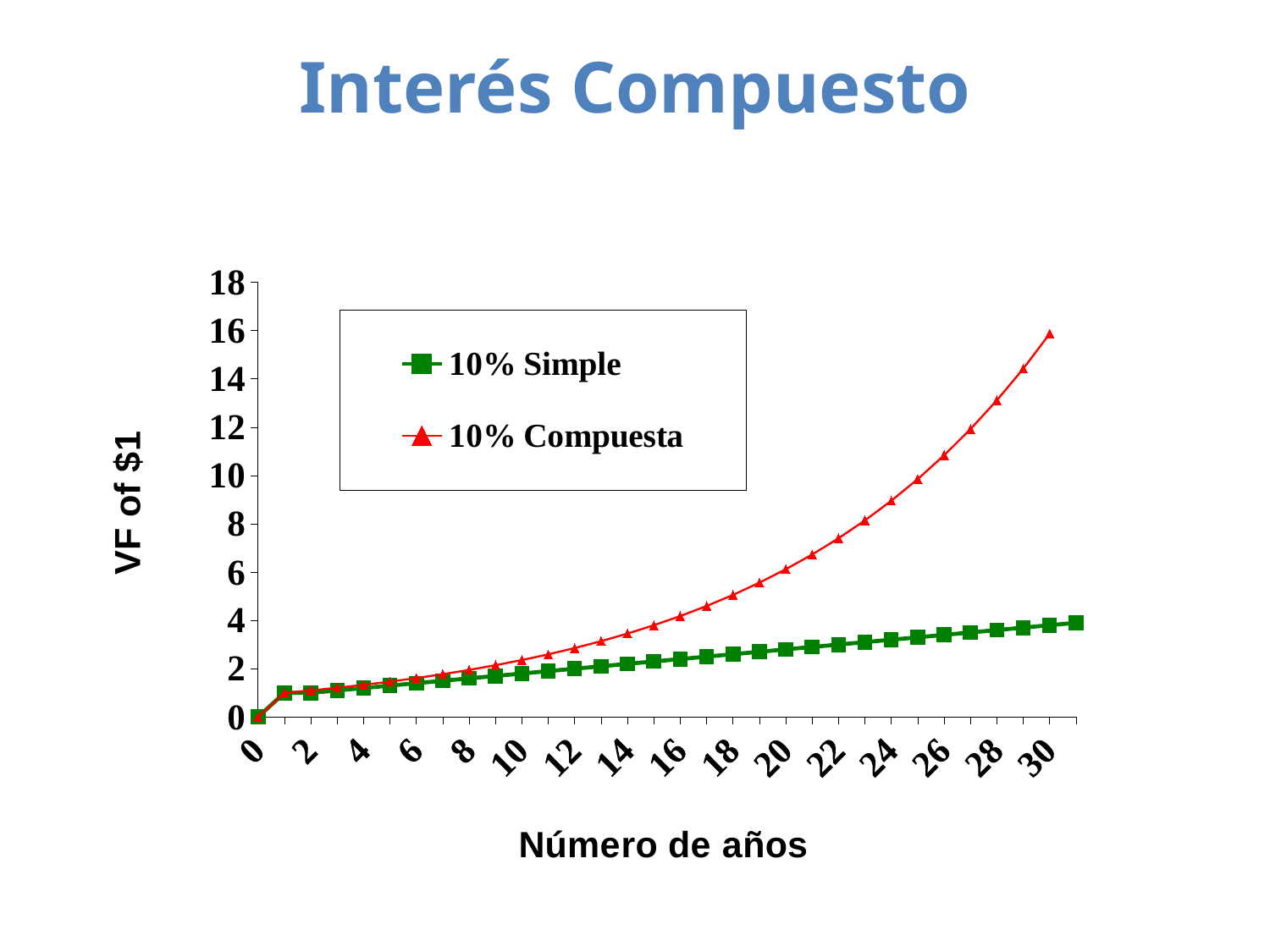
Is the value for 10% Compuesta at year 30 greater or less than 14? greater Do the values for 10% Compuesta rise or fall as the number of years increases? rise At year 30, which series has the higher value, 10% Simple or 10% Compuesta? 10% Compuesta Is the value for 10% Compuesta at year 26 greater or less than 8? greater What is the label of the y axis? VF of $1 How many series does the legend list? 2 Is the value for 10% Compuesta at year 20 greater or less than 4? greater What kind of chart is shown on the slide? line chart Do the values for 10% Simple rise or fall as the number of years increases? rise What are the two series named in the legend? 10% Simple and 10% Compuesta